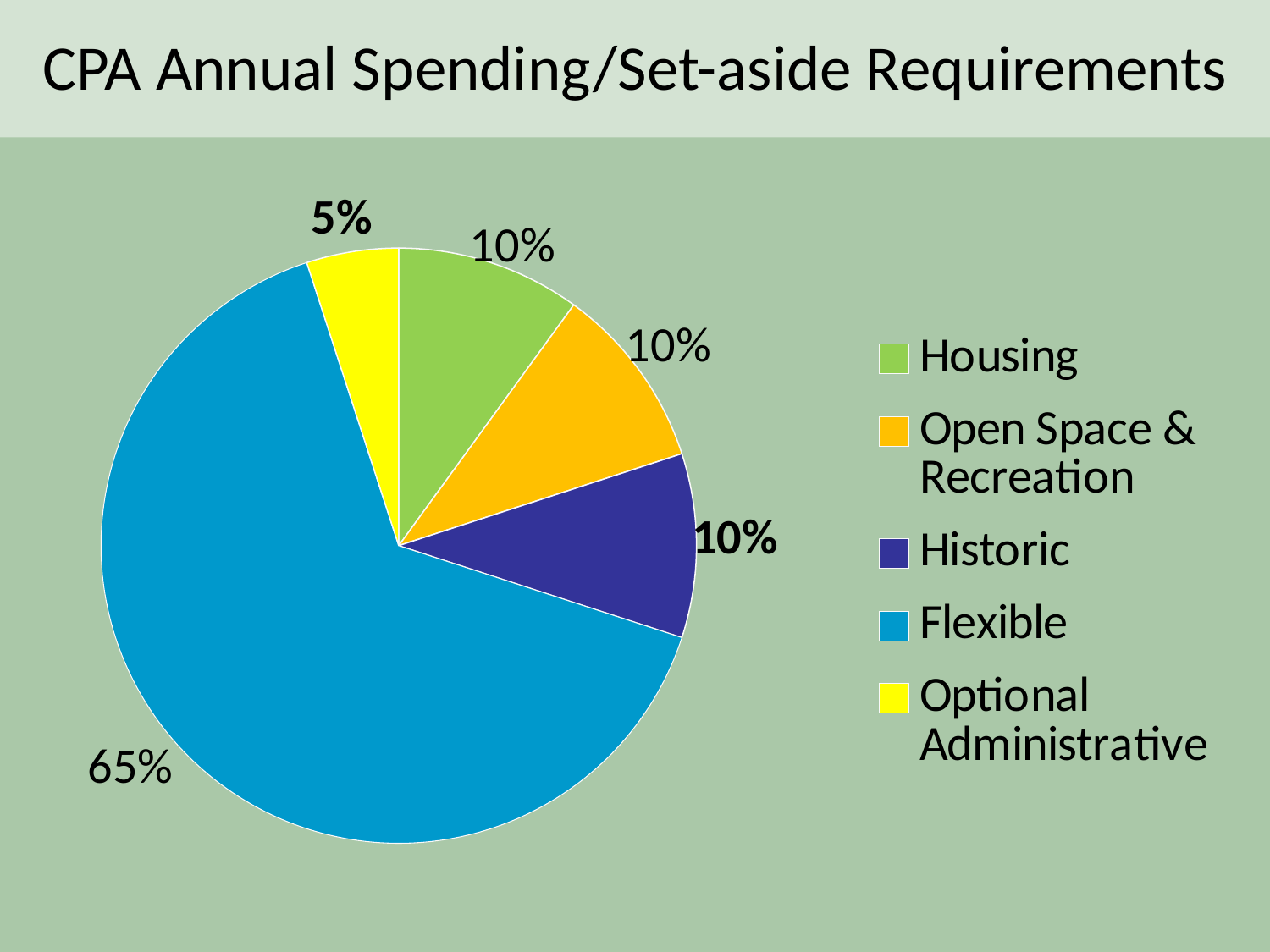
What percentage is shown for Flexible? 65% What percentage is shown for Optional Administrative? 5% Which category has the smallest slice of the pie? Optional Administrative How many categories does the legend list? 5 What percentage is shown for Housing? 10% What colour is the Flexible slice? blue What percentage is shown for Historic? 10% Which is larger, the share for Open Space & Recreation or the share for Optional Administrative? Open Space & Recreation What kind of chart is shown on the slide? pie chart Which category has the largest slice of the pie? Flexible What is the title of the chart? CPA Annual Spending/Set-aside Requirements What is the difference between the Flexible share and the Housing share? 55%